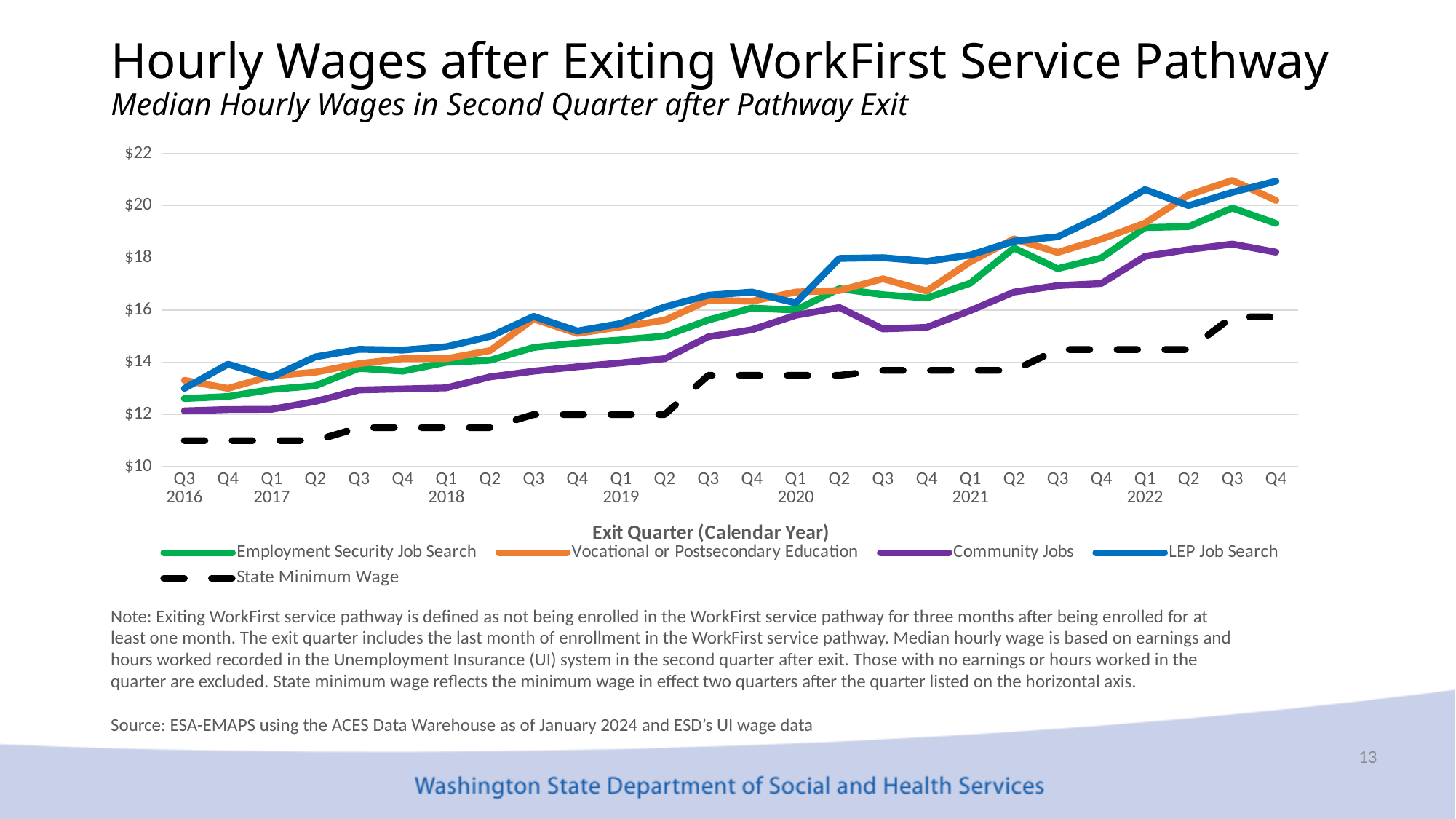
What is the title of the horizontal axis? Exit Quarter (Calendar Year) Is the value for LEP Job Search in Q4 2022 greater or less than $20? greater Is the value for Employment Security Job Search in Q4 2022 greater or less than $20? less Which series has the lowest values across the whole chart? State Minimum Wage What kind of chart is shown on the slide? line chart Do the median hourly wages for LEP Job Search generally rise or fall from Q3 2016 to Q4 2022? rise Is the State Minimum Wage value in Q3 2016 greater or less than $12? less How many series does the legend list? 5 In Q4 2022, which is higher: LEP Job Search or Community Jobs? LEP Job Search Which series is drawn as a dashed black line? State Minimum Wage How many exit quarters are plotted along the x axis? 26